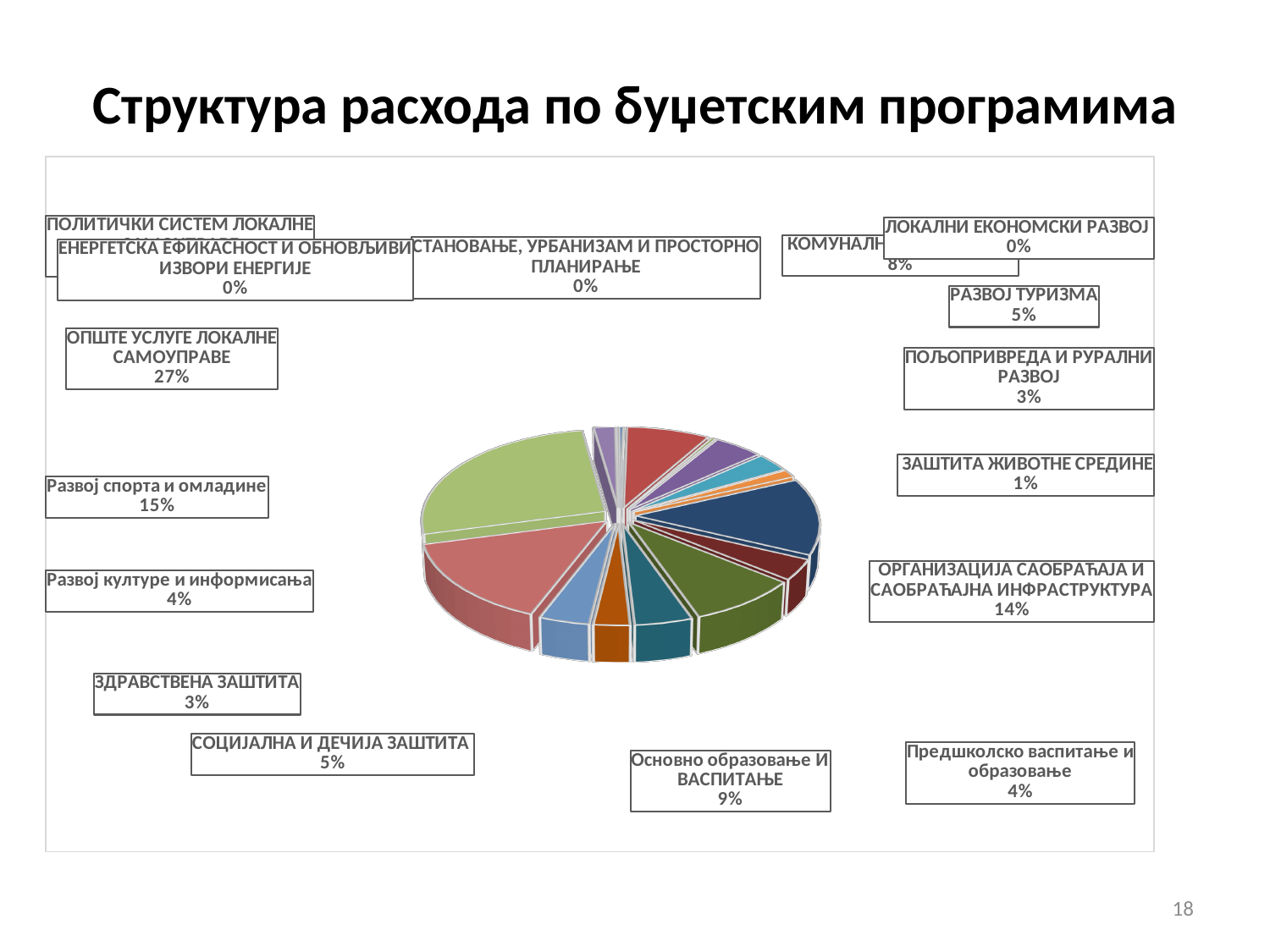
What share of expenditure goes to ЗАШТИТА ЖИВОТНЕ СРЕДИНЕ? 1% What is the combined share of Предшколско васпитање и образовање and Основно образовање И ВАСПИТАЊЕ? 13% What share of expenditure goes to Основно образовање И ВАСПИТАЊЕ? 9% What type of chart is shown on the slide? Pie chart What is the difference in share between ОПШТЕ УСЛУГЕ ЛОКАЛНЕ САМОУПРАВЕ and Развој спорта и омладине? 12% What share of expenditure goes to ОПШТЕ УСЛУГЕ ЛОКАЛНЕ САМОУПРАВЕ? 27% Which has a larger share: СОЦИЈАЛНА И ДЕЧИЈА ЗАШТИТА or ЗДРАВСТВЕНА ЗАШТИТА? СОЦИЈАЛНА И ДЕЧИЈА ЗАШТИТА What share of expenditure goes to РАЗВОЈ ТУРИЗМА? 5% What share of expenditure goes to Развој спорта и омладине? 15% Which budget program has the largest share of expenditure? ОПШТЕ УСЛУГЕ ЛОКАЛНЕ САМОУПРАВЕ What is the title of the slide? Структура расхода по буџетским програмима What share of expenditure goes to ОРГАНИЗАЦИЈА САОБРАЋАЈА И САОБРАЋАЈНА ИНФРАСТРУКТУРА? 14%